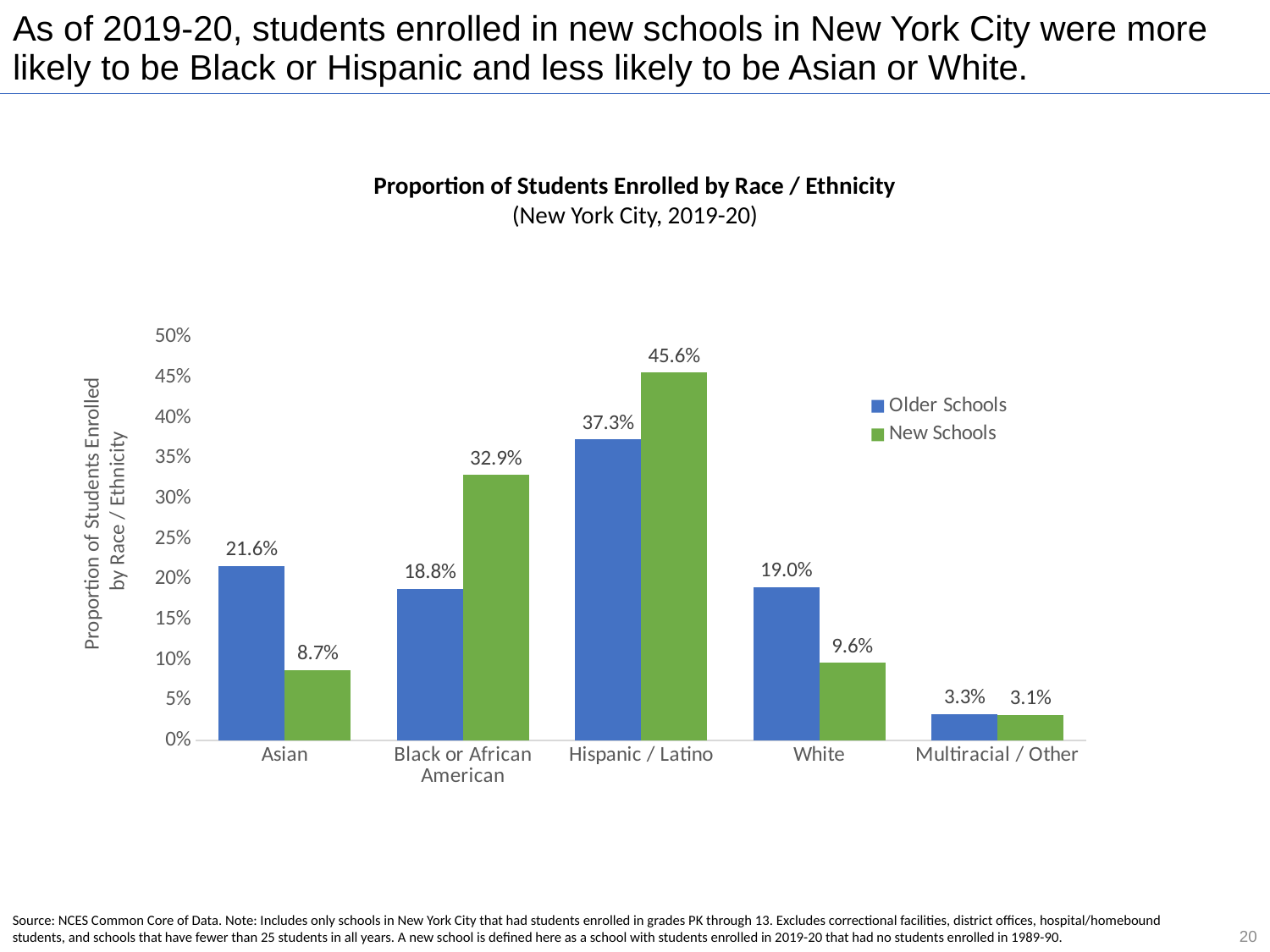
What is the value for New Schools in the White category? 9.6% Which series is shown in green in the legend? New Schools What kind of chart is shown on the slide? Bar chart Which category has the highest value for Older Schools? Hispanic / Latino What is the value for New Schools in the Hispanic / Latino category? 45.6% What is the value for Older Schools in the Asian category? 21.6% Which is larger for the White category, Older Schools or New Schools? Older Schools How many series does the legend list? 2 Which category has the lowest value for New Schools? Multiracial / Other How many race / ethnicity categories are shown on the x axis? 5 What is the difference between the Older Schools and New Schools values for Asian? 12.9% What is the difference between the New Schools and Older Schools values for Black or African American? 14.1%